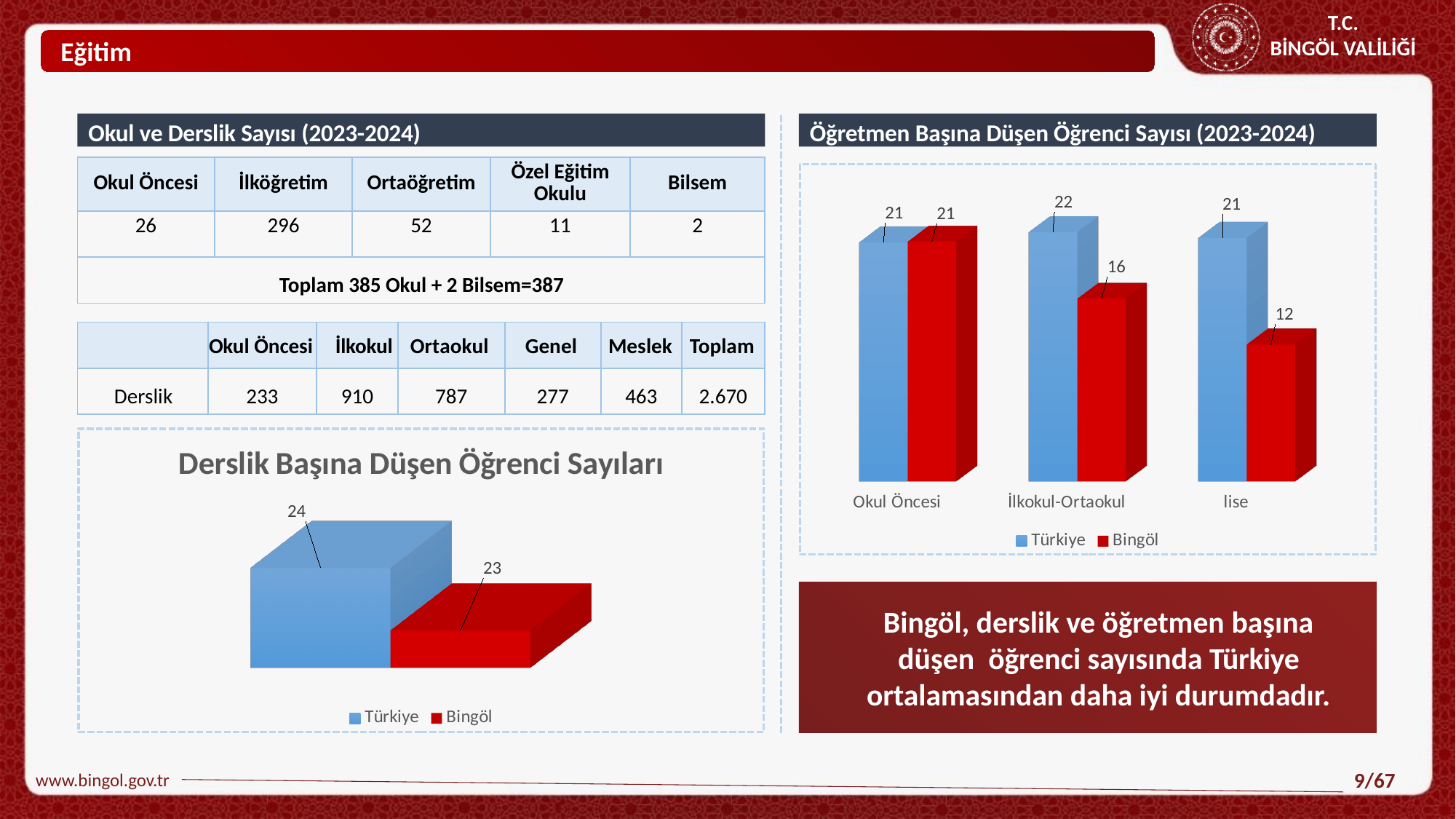
In the 'Öğretmen Başına Düşen Öğrenci Sayısı (2023-2024)' chart, how many categories are shown on the x axis? 3 In the 'Öğretmen Başına Düşen Öğrenci Sayısı (2023-2024)' chart, what is the Türkiye value for lise? 21 In the 'Öğretmen Başına Düşen Öğrenci Sayısı (2023-2024)' chart, what is the difference between the Türkiye and Bingöl values for lise? 9 In the 'Derslik Başına Düşen Öğrenci Sayıları' chart, what is the value for Türkiye? 24 In the 'Derslik Başına Düşen Öğrenci Sayıları' chart, how many series does the legend list? 2 In the 'Öğretmen Başına Düşen Öğrenci Sayısı (2023-2024)' chart, which category has the lowest Bingöl value? lise In the 'Öğretmen Başına Düşen Öğrenci Sayısı (2023-2024)' chart, which category has the highest Türkiye value? İlkokul-Ortaokul What kind of chart is 'Derslik Başına Düşen Öğrenci Sayıları'? Bar chart In the 'Derslik Başına Düşen Öğrenci Sayıları' chart, what is the value for Bingöl? 23 In the 'Öğretmen Başına Düşen Öğrenci Sayısı (2023-2024)' chart, what is the Bingöl value for İlkokul-Ortaokul? 16 In the 'Öğretmen Başına Düşen Öğrenci Sayısı (2023-2024)' chart, what is the Bingöl value for Okul Öncesi? 21 In the 'Derslik Başına Düşen Öğrenci Sayıları' chart, what is the difference between the Türkiye and Bingöl values? 1